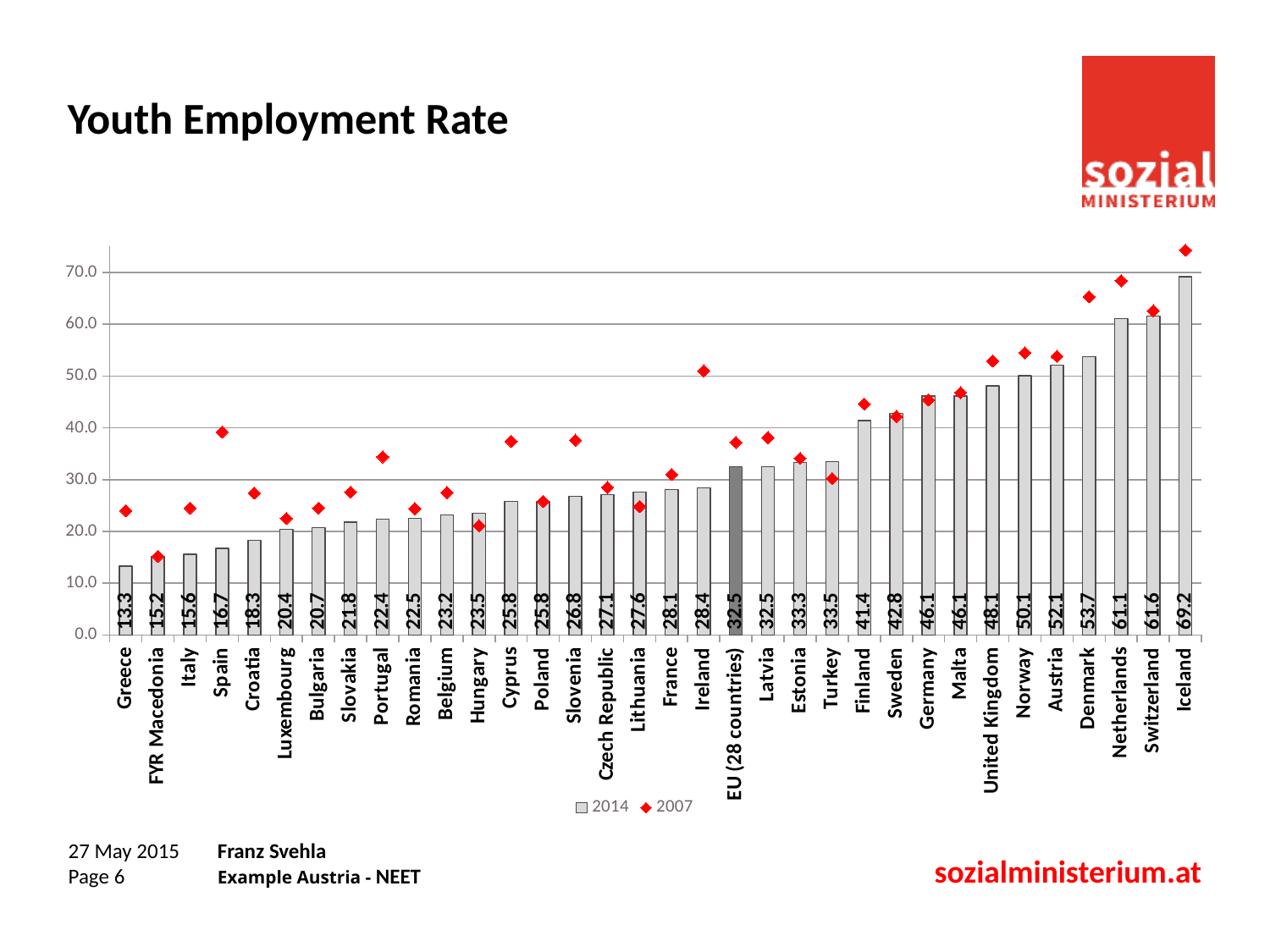
What is the difference between the 2014 values for Iceland and Greece? 55.9 How many series does the legend list? 2 What type of chart is shown on the slide? Bar chart with diamond markers Which has a higher 2014 value, Finland or Sweden? Sweden Is the 2007 value for Ireland greater or less than 40.0? greater What is the 2014 value shown for EU (28 countries)? 32.5 Which country has the lowest 2014 youth employment rate? Greece What is the 2014 youth employment rate for Austria? 52.1 Is the 2007 value for Spain greater or less than 30.0? greater What is the 2014 value for Germany? 46.1 Which country has the highest 2014 youth employment rate? Iceland Do the 2014 bar values rise or fall from left to right along the x axis? Rise